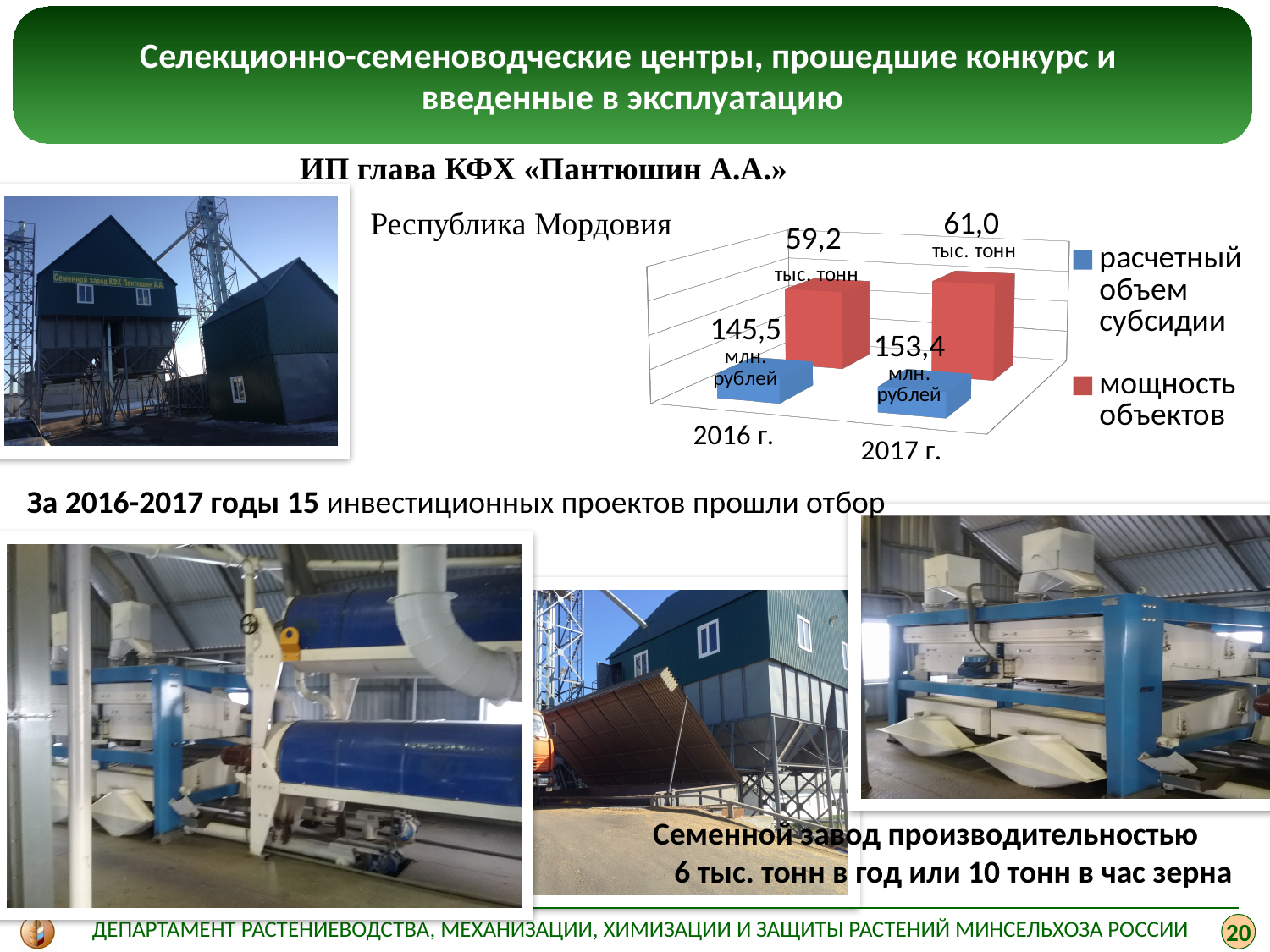
What is the value of мощность объектов for 2016 г.? 59,2 тыс. тонн How many series does the chart legend list? 2 Which is larger: мощность объектов in 2016 г. or in 2017 г.? 2017 г. In which year is расчетный объем субсидии higher? 2017 г. What is the value of расчетный объем субсидии for 2017 г.? 153,4 млн. рублей What is the value of расчетный объем субсидии for 2016 г.? 145,5 млн. рублей By how much does расчетный объем субсидии in 2017 г. exceed that in 2016 г.? 7,9 млн. рублей How many years (categories) are shown on the x axis of the chart? 2 In which year is мощность объектов lower? 2016 г. What type of chart is shown on the slide? Bar chart What is the value of мощность объектов for 2017 г.? 61,0 тыс. тонн What is the difference in мощность объектов between 2017 г. and 2016 г.? 1,8 тыс. тонн